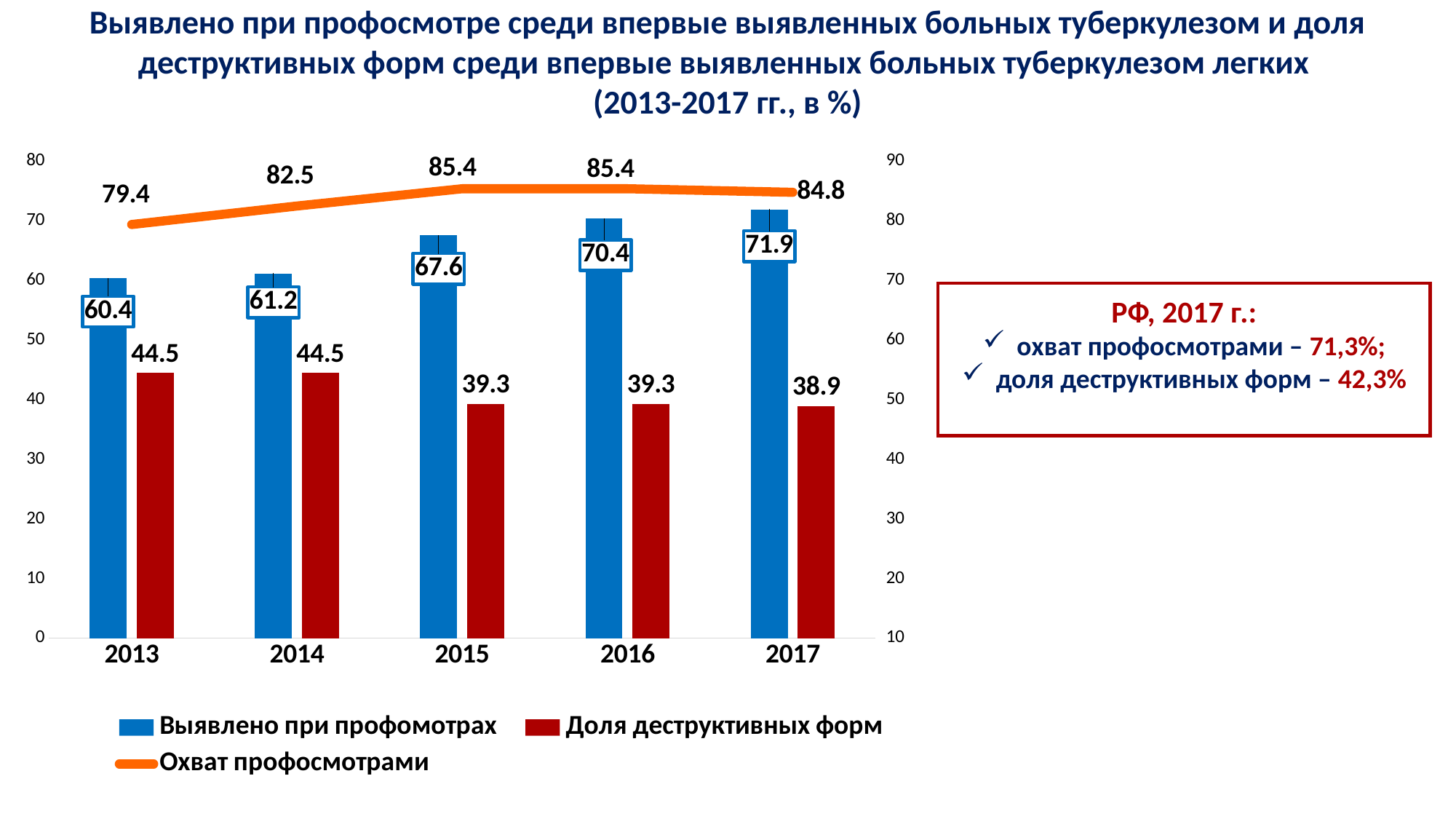
What is the difference between the "Выявлено при профомотрах" values for 2017 and 2013? 11.5 What is the value of "Выявлено при профомотрах" for 2015? 67.6 Which is larger: "Доля деструктивных форм" in 2014 or in 2016? 2014 In which year is "Выявлено при профомотрах" highest? 2017 What is the value of "Доля деструктивных форм" for 2017? 38.9 What is the value of "Охват профосмотрами" for 2014? 82.5 How many years are shown on the x axis? 5 How many series does the legend list? 3 Does "Выявлено при профомотрах" rise or fall from 2013 to 2017? Rise In which year is "Доля деструктивных форм" lowest? 2017 What colour is the "Охват профосмотрами" line? Orange What kind of chart is shown on the slide? Combined bar and line chart